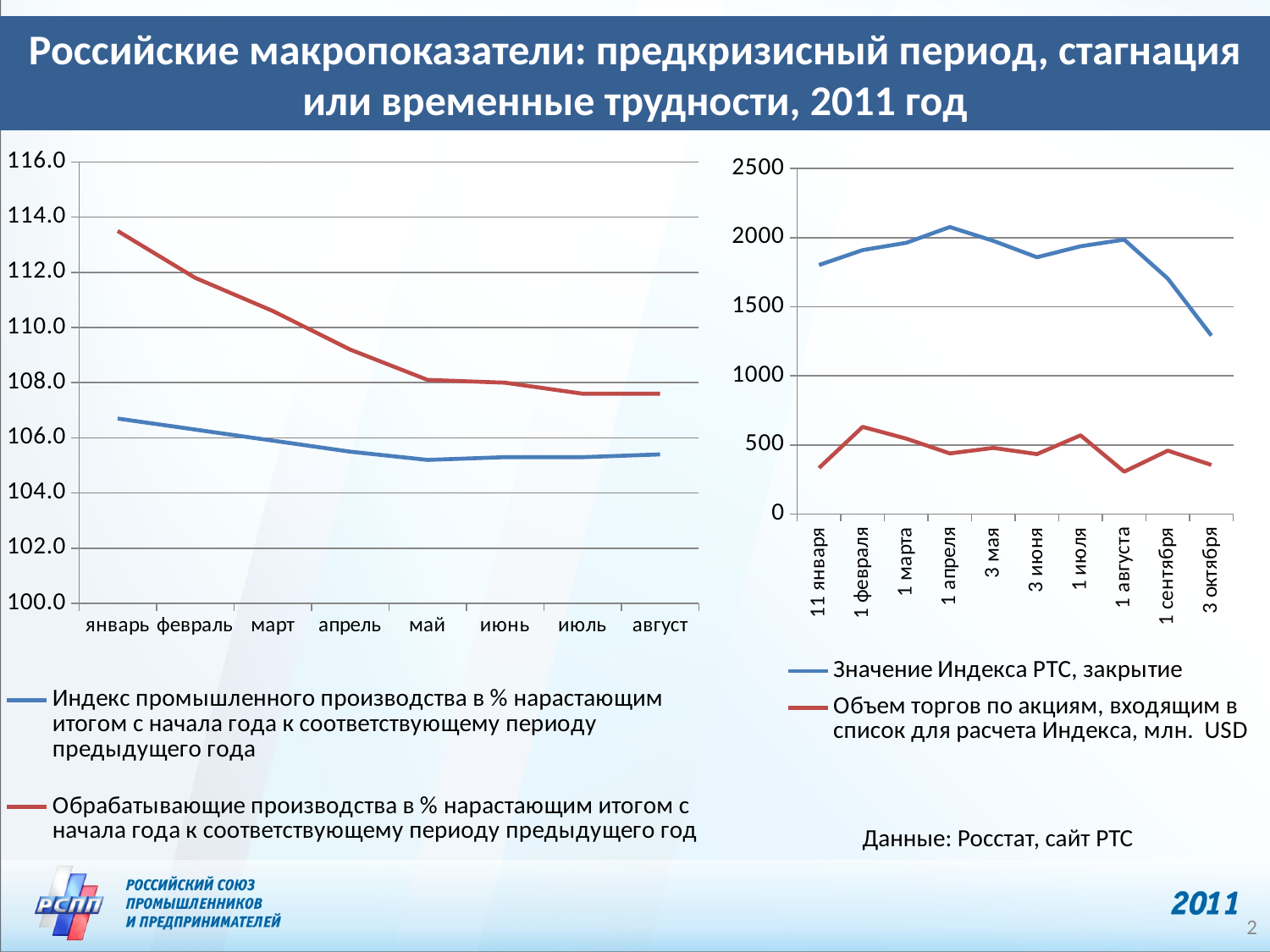
In the left chart, is the value for Обрабатывающие производства in январь greater or less than 112.0? greater In the left chart, which series has the higher value in январь? Обрабатывающие производства In the right chart, on which date is the value of Значение Индекса РТС, закрытие highest? 1 апреля How many series does the legend of the left chart list? 2 In the right chart, is the value of Значение Индекса РТС, закрытие on 3 октября greater or less than 1500? less In the left chart, is the value for Индекс промышленного производства in май greater or less than 106.0? less In the left chart, in which month is the value for Обрабатывающие производства highest? январь What kind of chart is the left chart on the slide? line chart What data source is cited below the right chart? Росстат, сайт РТС In the left chart, does the red line (Обрабатывающие производства) rise or fall from январь to август? fall How many dates are shown on the x axis of the right chart? 10 How many months are shown on the x axis of the left chart? 8